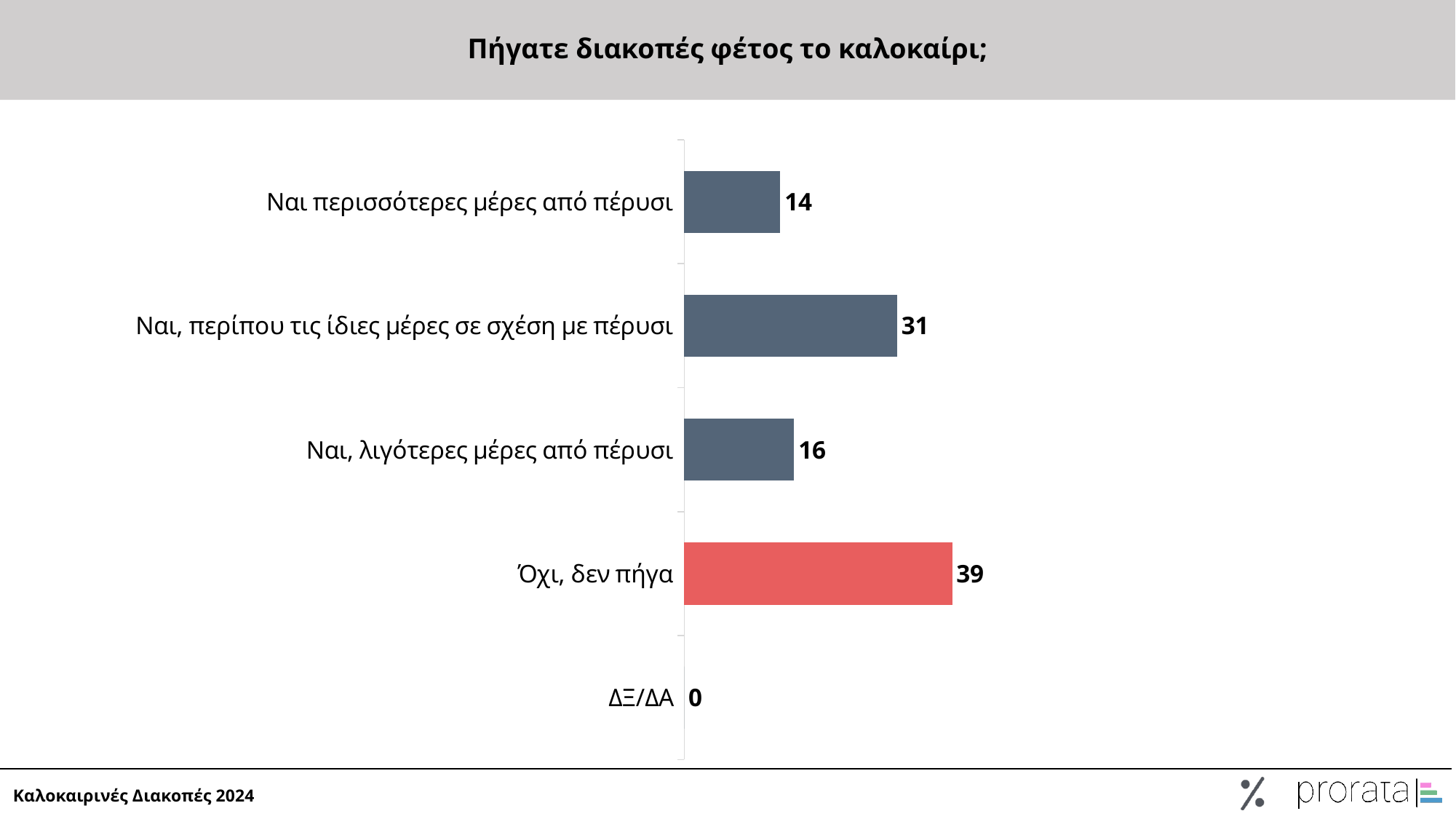
What is the value for 'ΔΞ/ΔΑ'? 0 What is the value for 'Ναι, περίπου τις ίδιες μέρες σε σχέση με πέρυσι'? 31 Which is larger: 'Ναι, λιγότερες μέρες από πέρυσι' or 'Ναι περισσότερες μέρες από πέρυσι'? Ναι, λιγότερες μέρες από πέρυσι Which category has the lowest value? ΔΞ/ΔΑ Which bar is coloured red rather than grey? Όχι, δεν πήγα What is the title of the chart? Πήγατε διακοπές φέτος το καλοκαίρι; What is the value for 'Όχι, δεν πήγα'? 39 What is the value for 'Ναι περισσότερες μέρες από πέρυσι'? 14 What is the difference between 'Όχι, δεν πήγα' and 'Ναι, περίπου τις ίδιες μέρες σε σχέση με πέρυσι'? 8 Which category has the highest value? Όχι, δεν πήγα What kind of chart is shown on the slide? Bar chart How many categories are shown in the chart? 5